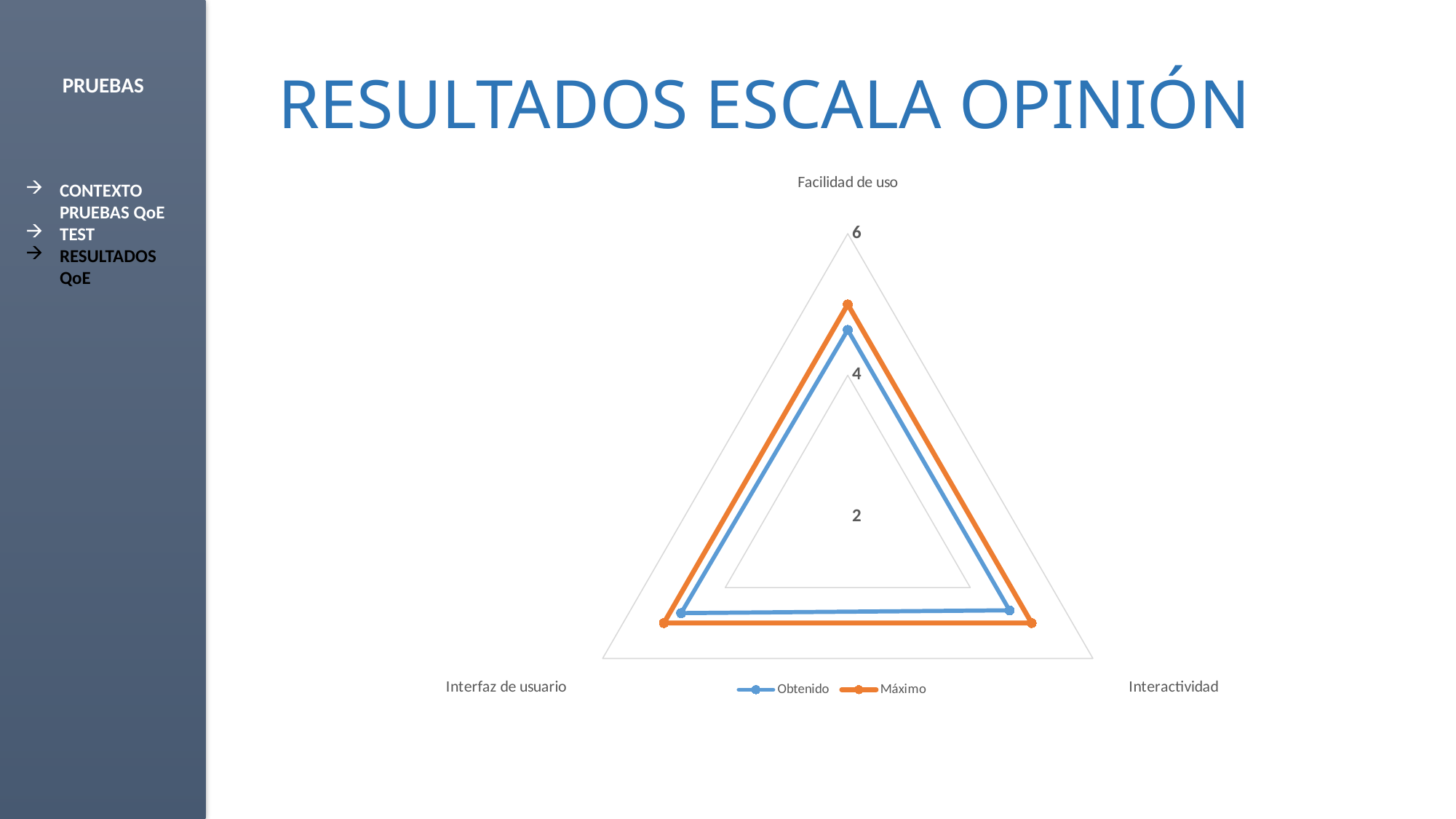
What is the title of the slide containing the chart? RESULTADOS ESCALA OPINIÓN How many categories (axes) does the radar chart have? 3 Is the Máximo value for Interactividad greater or less than 6? less Is the Máximo value for Facilidad de uso greater or less than 4? greater For Facilidad de uso, which series has the larger value, Obtenido or Máximo? Máximo Which series is drawn in orange? Máximo For Interactividad, which series has the larger value, Obtenido or Máximo? Máximo Is the Obtenido value for Facilidad de uso greater or less than 6? less For Interfaz de usuario, which series has the smaller value, Obtenido or Máximo? Obtenido What kind of chart is shown on the slide? Radar chart How many series does the legend list? 2